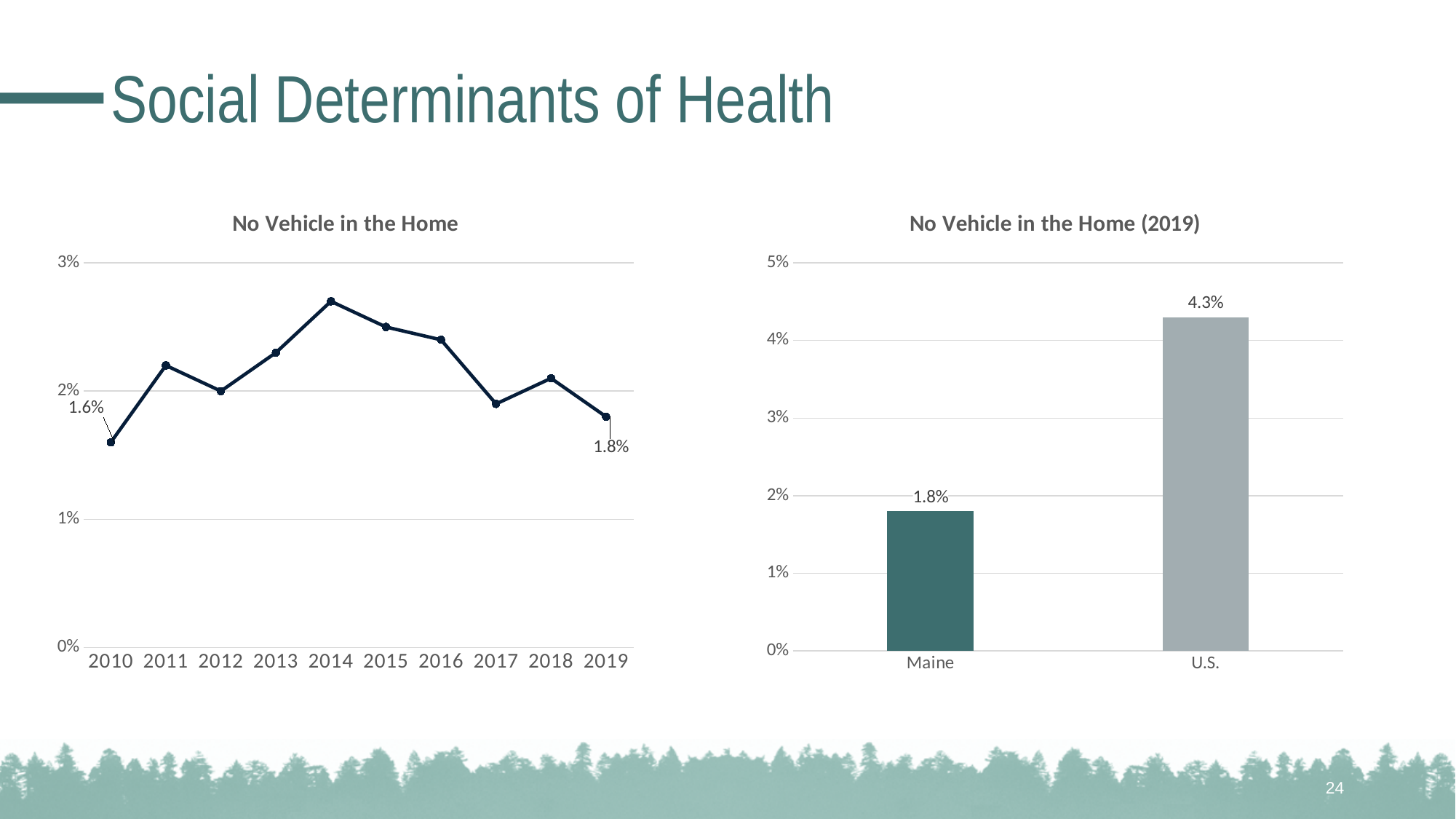
What kind of chart is 'No Vehicle in the Home (2019)'? bar chart In the 'No Vehicle in the Home (2019)' chart, what is the value for the U.S.? 4.3% In the 'No Vehicle in the Home' line chart, what is the value for 2010? 1.6% In the 'No Vehicle in the Home' line chart, which year has the highest value? 2014 In the 'No Vehicle in the Home' line chart, how many years are plotted? 10 In the 'No Vehicle in the Home (2019)' chart, which category has the lower value? Maine In the 'No Vehicle in the Home' line chart, is the value for 2015 higher or lower than the value for 2017? higher In the 'No Vehicle in the Home' line chart, which year has the lowest value? 2010 In the 'No Vehicle in the Home' line chart, what is the difference between the 2019 value and the 2010 value? 0.2% In the 'No Vehicle in the Home' line chart, is the value for 2014 greater or less than 2%? greater In the 'No Vehicle in the Home' line chart, what is the value for 2019? 1.8% In the 'No Vehicle in the Home (2019)' chart, what is the difference between the U.S. value and the Maine value? 2.5%